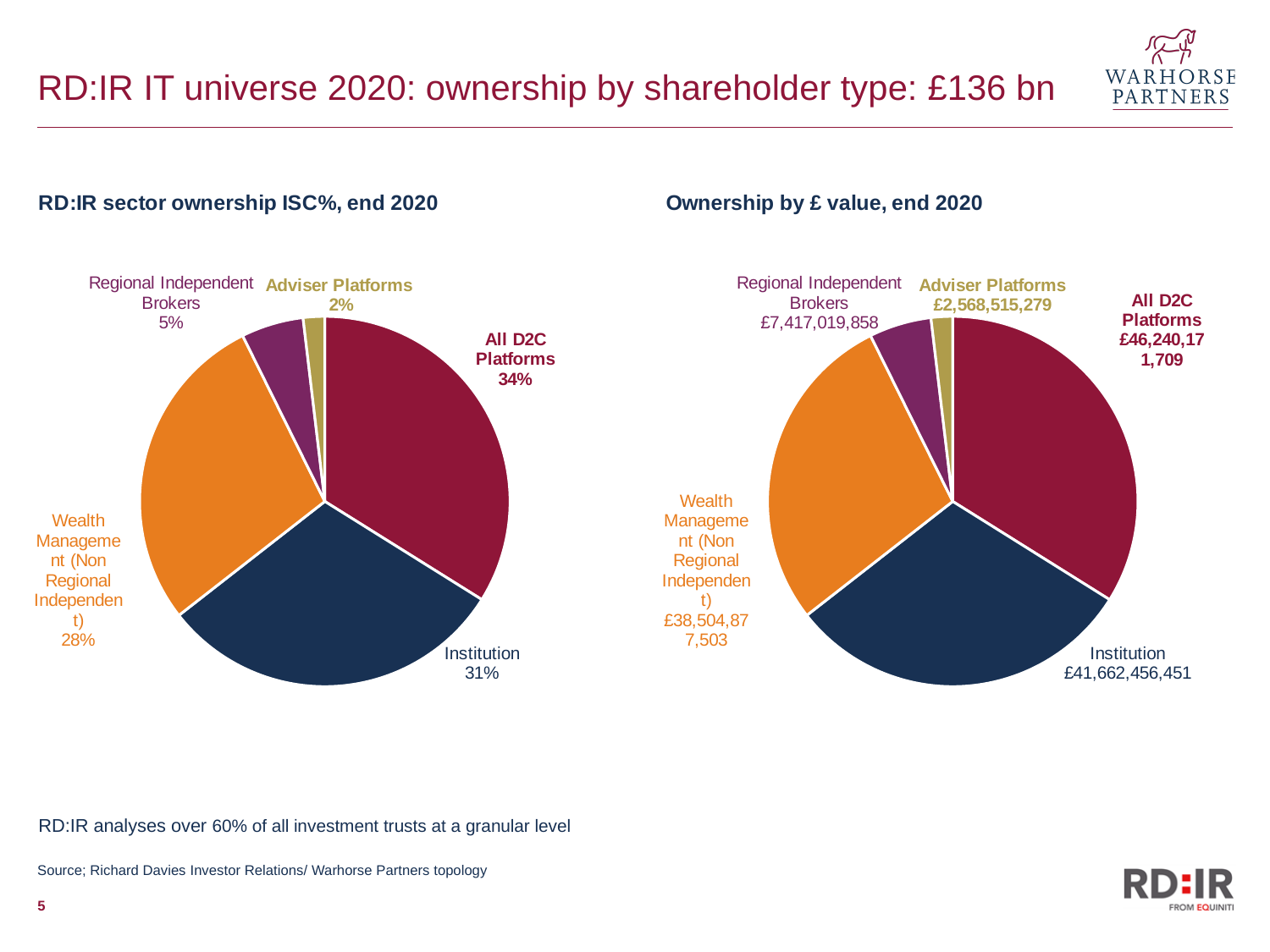
In the 'RD:IR sector ownership ISC%, end 2020' chart, which shareholder type has the largest share? All D2C Platforms How many shareholder types are shown in the 'Ownership by £ value, end 2020' chart? 5 In the 'Ownership by £ value, end 2020' chart, what is the value for Adviser Platforms? £2,568,515,279 In the 'Ownership by £ value, end 2020' chart, which is larger: Institution or Wealth Management (Non Regional Independent)? Institution What type of chart is used for 'RD:IR sector ownership ISC%, end 2020'? Pie chart In the 'RD:IR sector ownership ISC%, end 2020' chart, what share does Institution hold? 31% In the 'RD:IR sector ownership ISC%, end 2020' chart, what share does Wealth Management (Non Regional Independent) hold? 28% In the 'RD:IR sector ownership ISC%, end 2020' chart, which shareholder type has the smallest share? Adviser Platforms In the 'RD:IR sector ownership ISC%, end 2020' chart, what is the difference between the All D2C Platforms share and the Regional Independent Brokers share? 29% In the 'Ownership by £ value, end 2020' chart, what is the value for Regional Independent Brokers? £7,417,019,858 In the 'Ownership by £ value, end 2020' chart, what is the value for Institution? £41,662,456,451 In the 'Ownership by £ value, end 2020' chart, which shareholder type has the highest value? All D2C Platforms